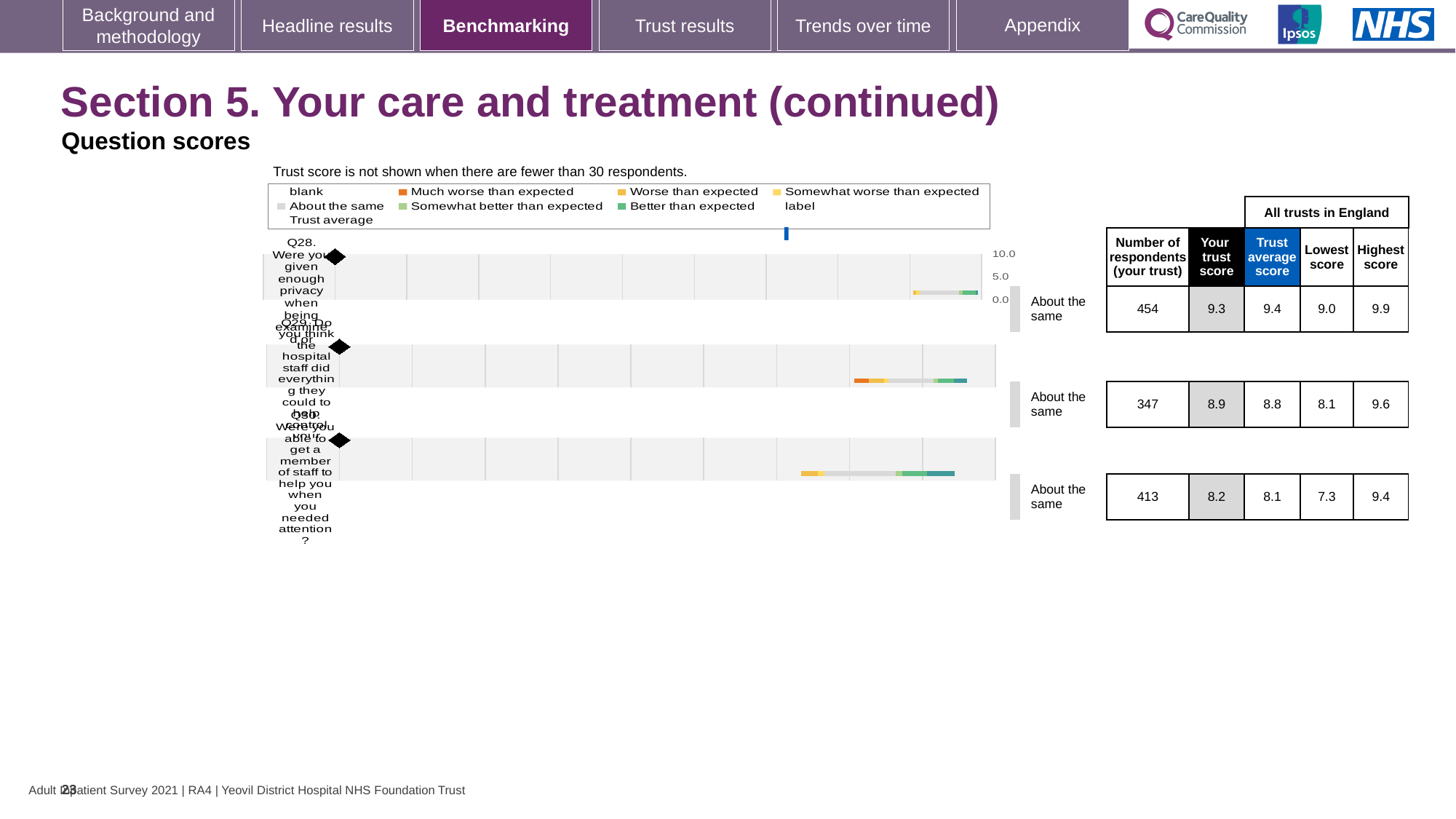
Which question has the lowest trust score on this slide? Q30 How many respondents from the trust answered Q28? 454 What is the trust score for Q30 (Were you able to get a member of staff to help you when you needed attention)? 8.2 What is the trust score for Q29 (Do you think the hospital staff did everything they could to help control your pain)? 8.9 What benchmark category is shown for Q30? About the same For Q29, which is larger: the trust score or the trust average score? Trust score How many questions are charted on this slide? 3 Which question has the highest trust score on this slide? Q28 What is the difference between the trust average score and the trust score for Q28? 0.1 What is the trust score for Q28 (Were you given enough privacy when being examined or treated)? 9.3 What is the highest score across all trusts in England for Q28? 9.9 What kind of chart is used to show the question scores? Bar chart